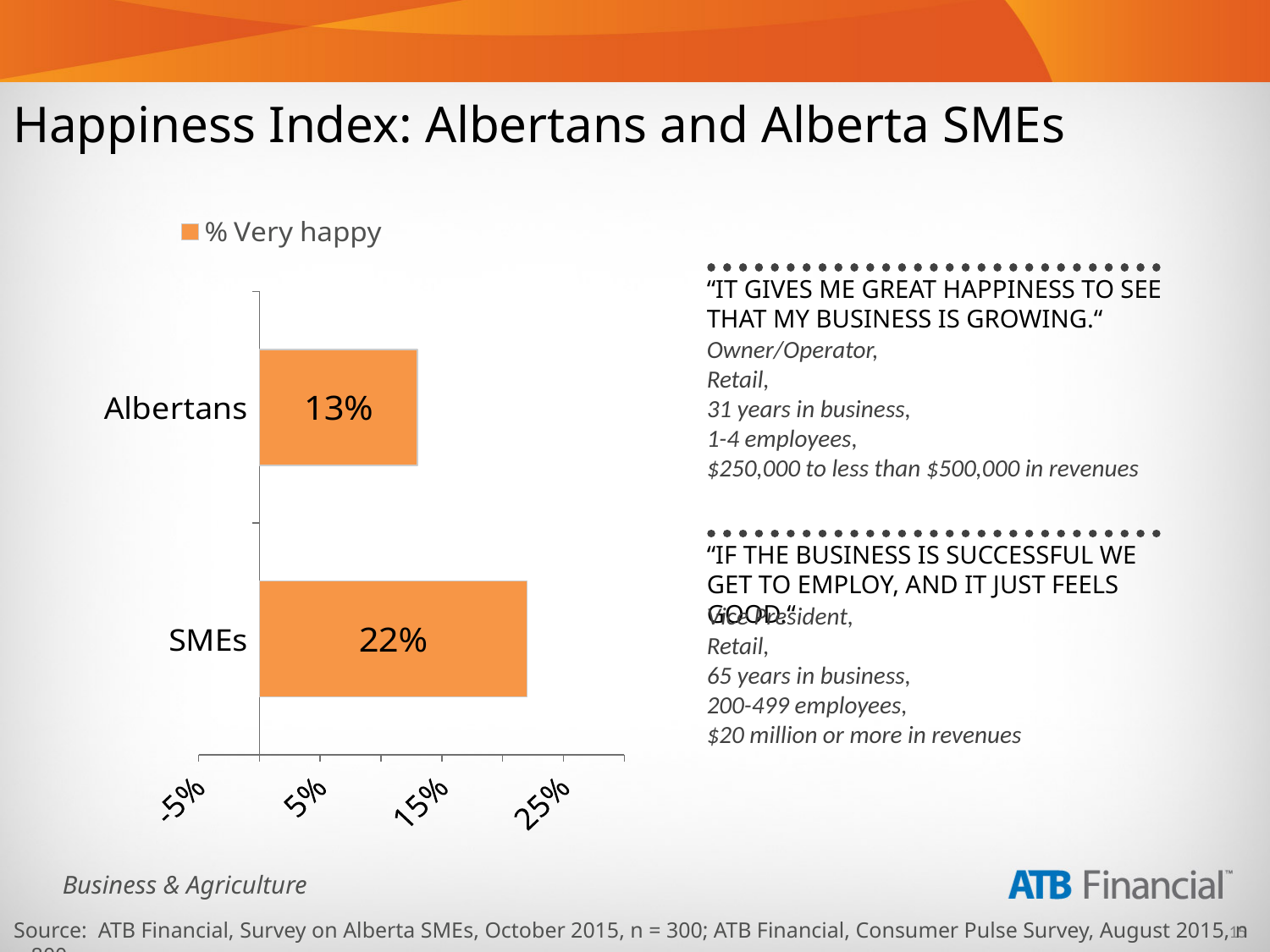
What is the % Very happy value for SMEs? 22% Is the value for SMEs greater or less than 15%? greater What is the difference between the % Very happy values for SMEs and Albertans? 9% What kind of chart is shown on the slide? Bar chart What is the legend entry for the series in the chart? % Very happy Is the % Very happy value larger for Albertans or for SMEs? SMEs Which category has the higher % Very happy value? SMEs What is the % Very happy value for Albertans? 13% Is the value for Albertans greater or less than 15%? less How many series does the legend list? 1 Which category has the lower % Very happy value? Albertans How many categories are shown in the chart? 2